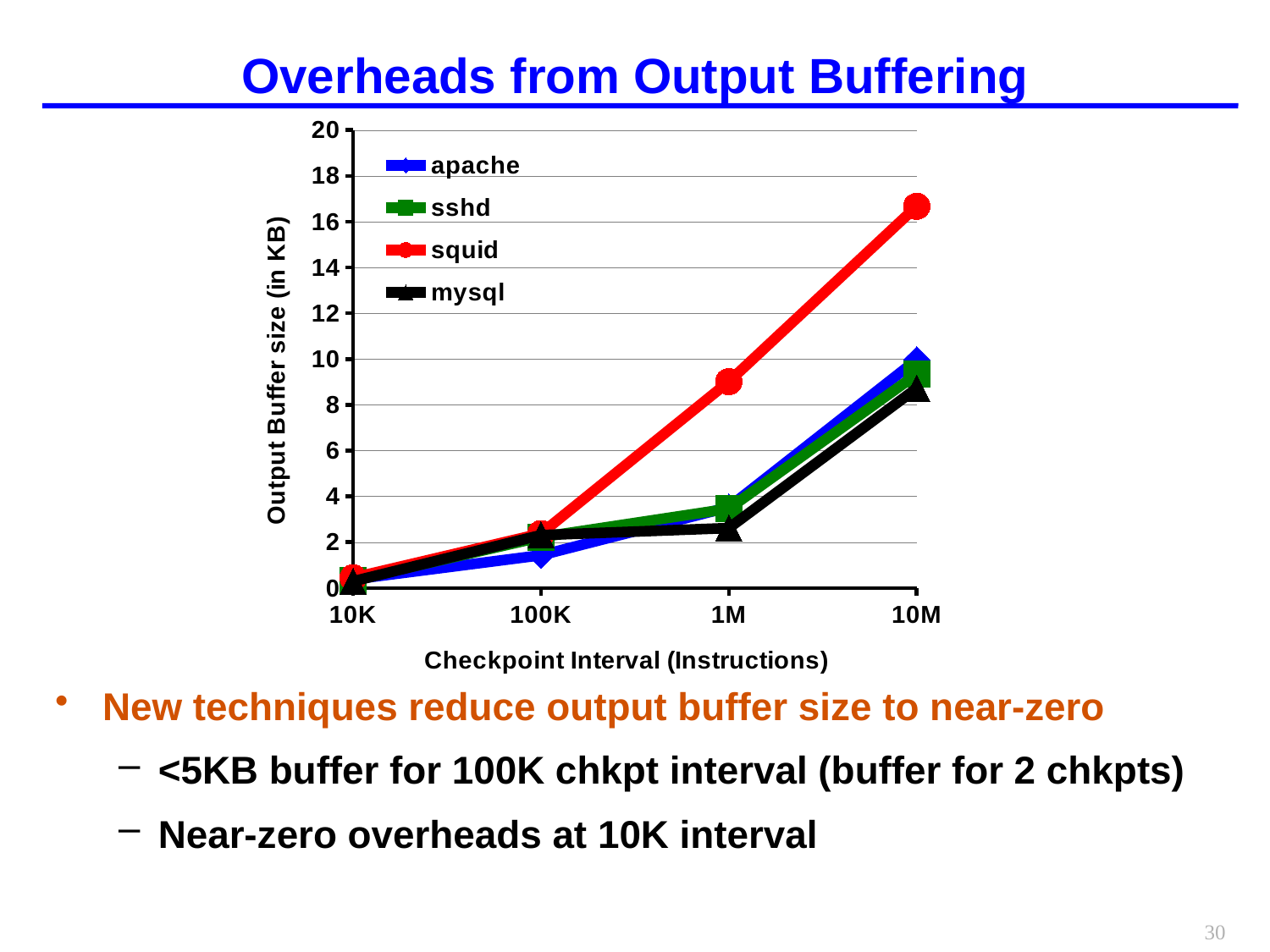
Is the value for squid at 10M greater or less than 14? greater Is the value for apache at 10M greater or less than 12? less What kind of chart is shown on the slide? line chart Is the value for squid at 1M greater or less than 8? greater Do the values for squid rise or fall as the checkpoint interval increases along the x axis? rise What is the label of the y axis? Output Buffer size (in KB) Which series has the highest output buffer size at the 10M checkpoint interval? squid How many checkpoint interval values are shown on the x axis? 4 At the 10M checkpoint interval, which is larger: squid or mysql? squid At the 1M checkpoint interval, which is larger: squid or apache? squid How many series does the legend list? 4